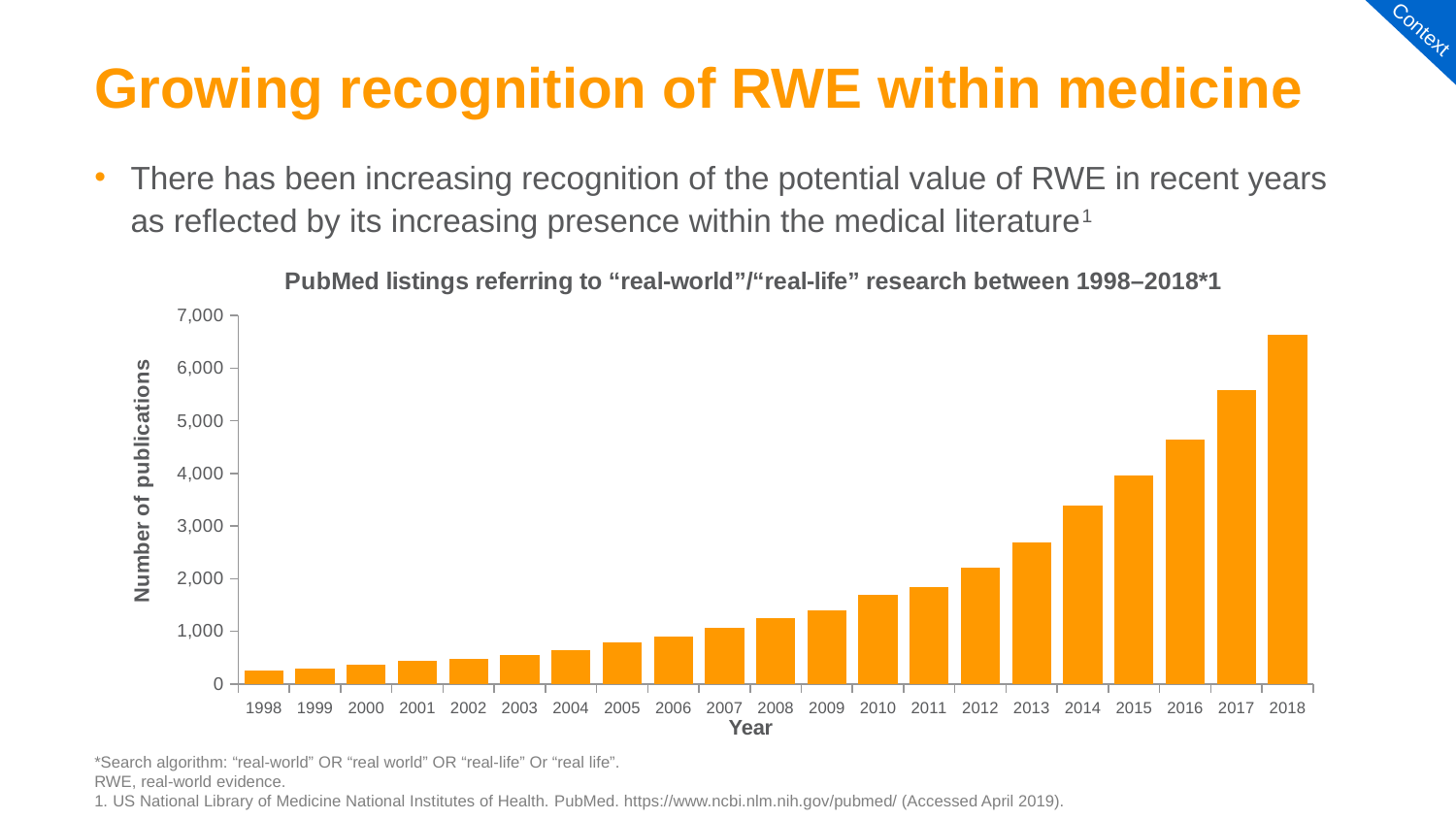
Do the number of publications rise or fall from 1998 to 2018? Rise Which year has the highest number of publications? 2018 Which year has more publications, 2013 or 2009? 2013 What is the title of the chart? PubMed listings referring to "real-world"/"real-life" research between 1998–2018*1 What kind of chart is shown on the slide? Bar chart Is the number of publications for 2005 greater or less than 1,000? less Is the number of publications for 2014 greater or less than 3,000? greater How many years (bars) are plotted on the chart? 21 Is the number of publications for 2016 greater or less than 5,000? less What is the label of the y axis? Number of publications Which year has the lowest number of publications? 1998